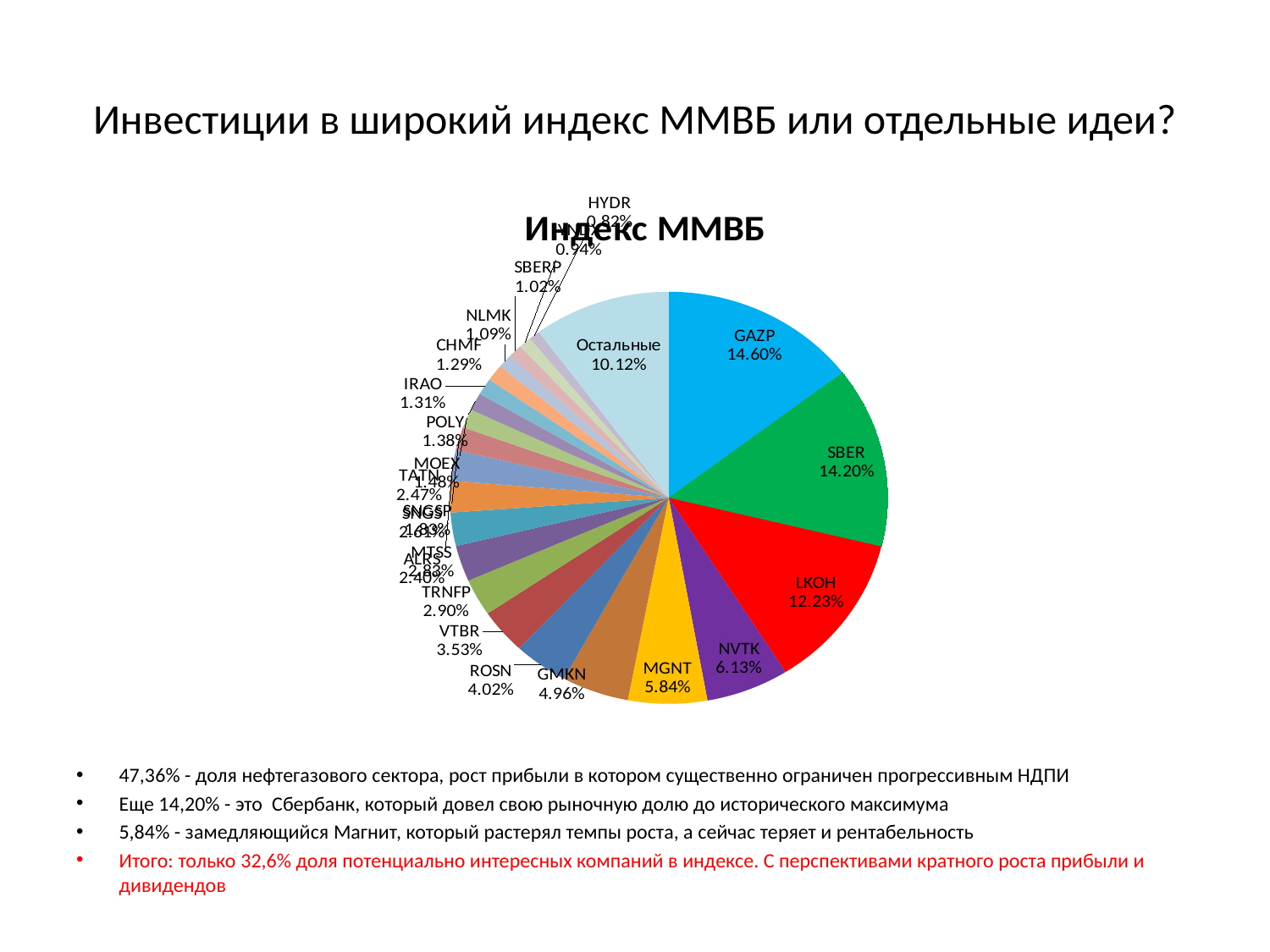
What is the value shown for HYDR? 0.82% What is the title of the chart? Индекс ММВБ What is the difference between the LKOH and NVTK shares? 6.10% What share of the index does GAZP hold? 14.60% What is the difference between the GAZP and SBER shares? 0.40% Which is larger, the share of ROSN or the share of VTBR? ROSN Which company has the largest slice in the pie chart? GAZP What is the value shown for LKOH? 12.23% What is the value shown for the 'Остальные' slice? 10.12% What kind of chart is shown on the slide? pie chart What is the value shown for SBER? 14.20% What is the value shown for MGNT? 5.84%